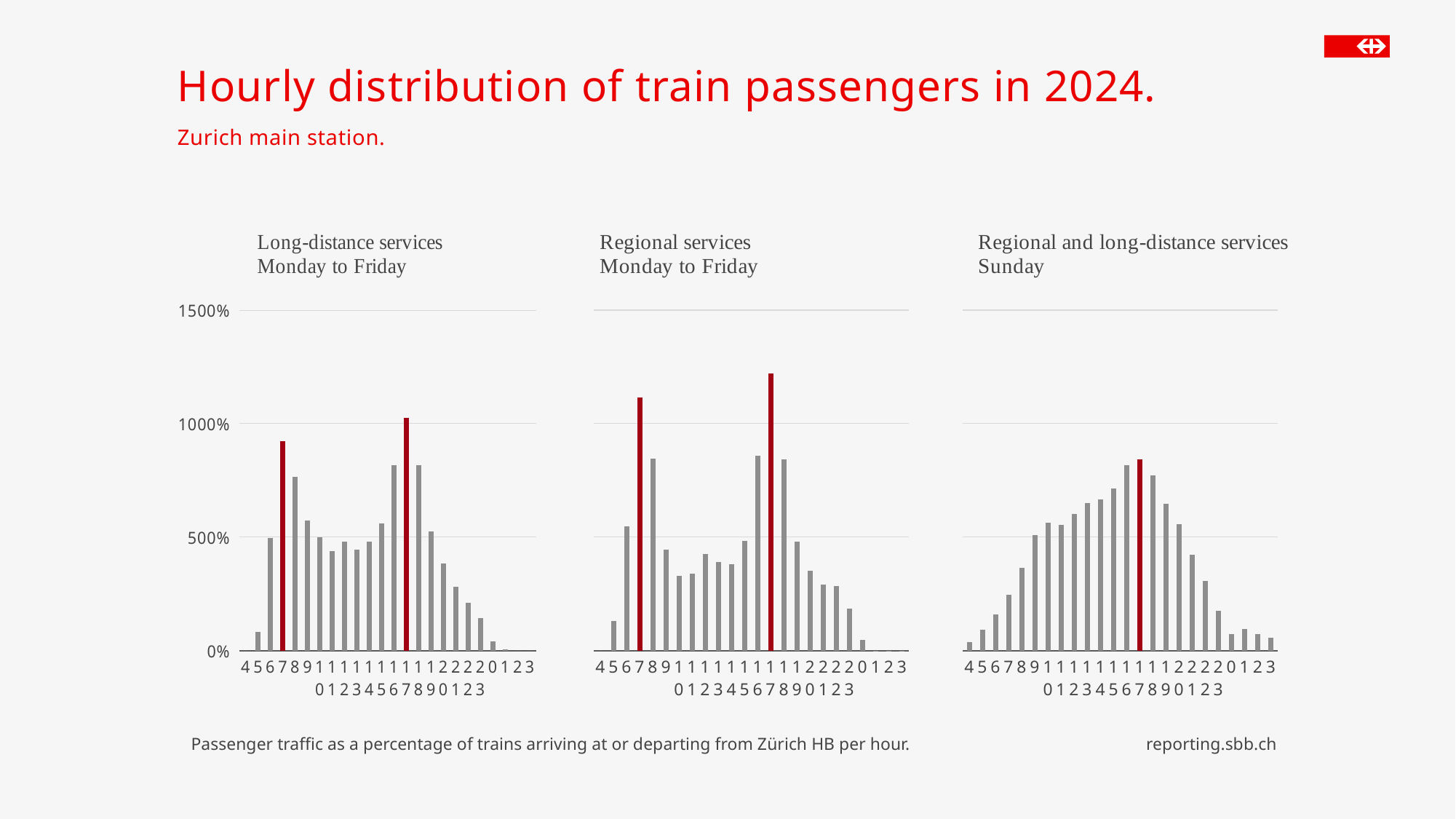
In the 'Regional services Monday to Friday' chart, is the value for hour 17 greater or less than 1000%? greater In the 'Regional and long-distance services Sunday' chart, is the value for hour 4 greater or less than 500%? less In the 'Regional services Monday to Friday' chart, how many hourly bars are plotted? 24 In the 'Long-distance services Monday to Friday' chart, is the value for hour 7 greater or less than 1000%? less How many charts are shown on the slide? 3 In the 'Long-distance services Monday to Friday' chart, which hour has the highest value? 17 In the 'Regional services Monday to Friday' chart, which hour has the highest value? 17 In the 'Regional and long-distance services Sunday' chart, do the values rise or fall from hour 4 to hour 17? rise In the 'Regional services Monday to Friday' chart, which is larger, the value for hour 7 or the value for hour 16? hour 7 What kind of chart is the 'Long-distance services Monday to Friday' chart? bar chart In the 'Long-distance services Monday to Friday' chart, which hours are highlighted with red bars? 7 and 17